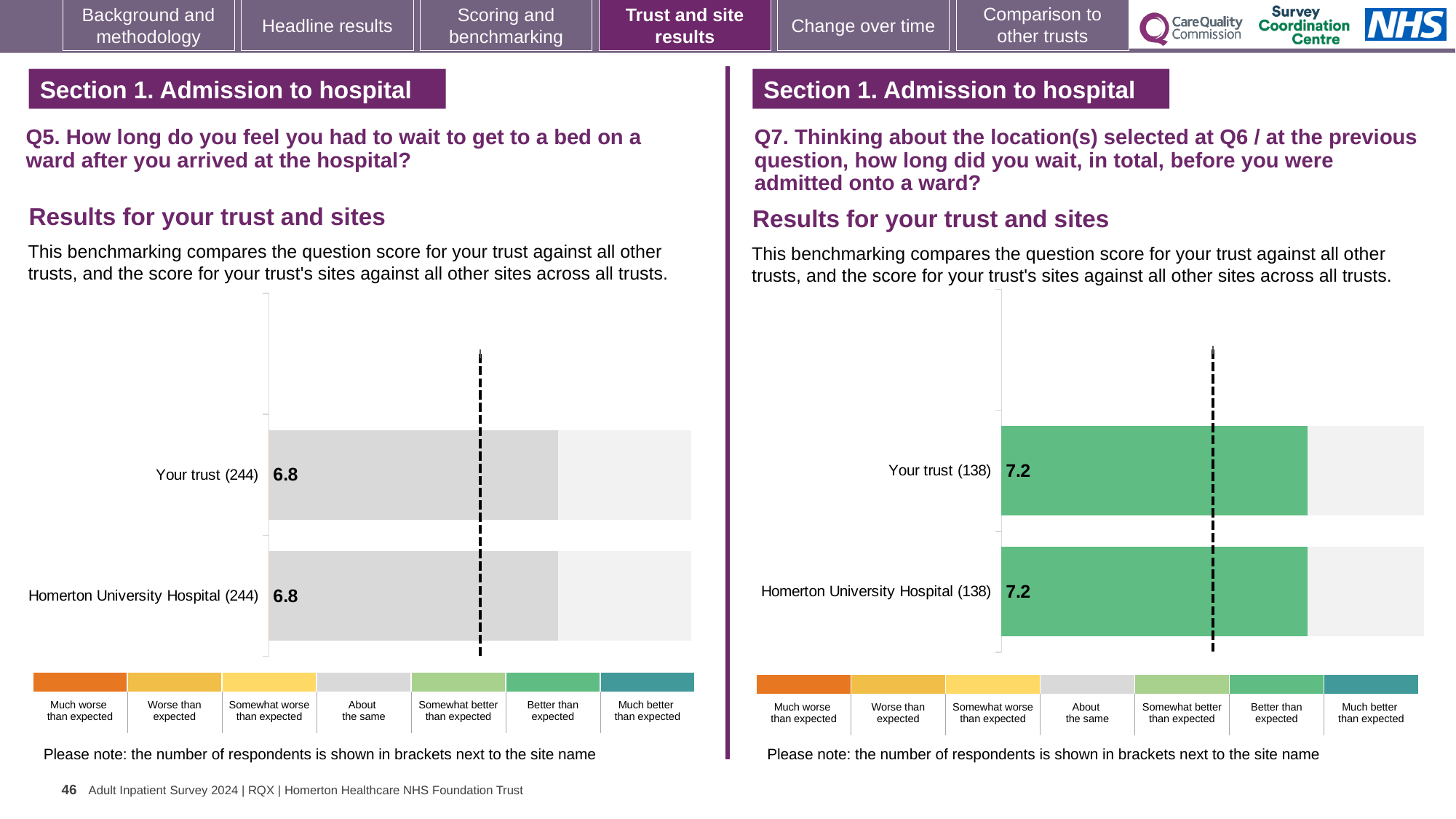
On the Q5 chart (left), how many bars are plotted? 2 What kind of chart is the Q5 chart on the left? Bar chart On the Q5 chart (left), what is the score for Homerton University Hospital? 6.8 On the Q5 chart (left), what is the score for Your trust? 6.8 On the Q7 chart (right), how many bars are plotted? 2 On the Q7 chart (right), what is the score for Your trust? 7.2 On the Q5 chart (left), how many respondents are shown in brackets for Your trust? 244 On the Q7 chart (right), how many respondents are shown in brackets for Homerton University Hospital? 138 On the Q7 chart (right), what is the difference between the score for Your trust and the score for Homerton University Hospital? 0.0 On the Q5 chart (left), which benchmark category does the grey colour of the bars correspond to in the legend? About the same On the Q7 chart (right), what is the score for Homerton University Hospital? 7.2 On the Q7 chart (right), which benchmark category does the green colour of the bars correspond to in the legend? Better than expected